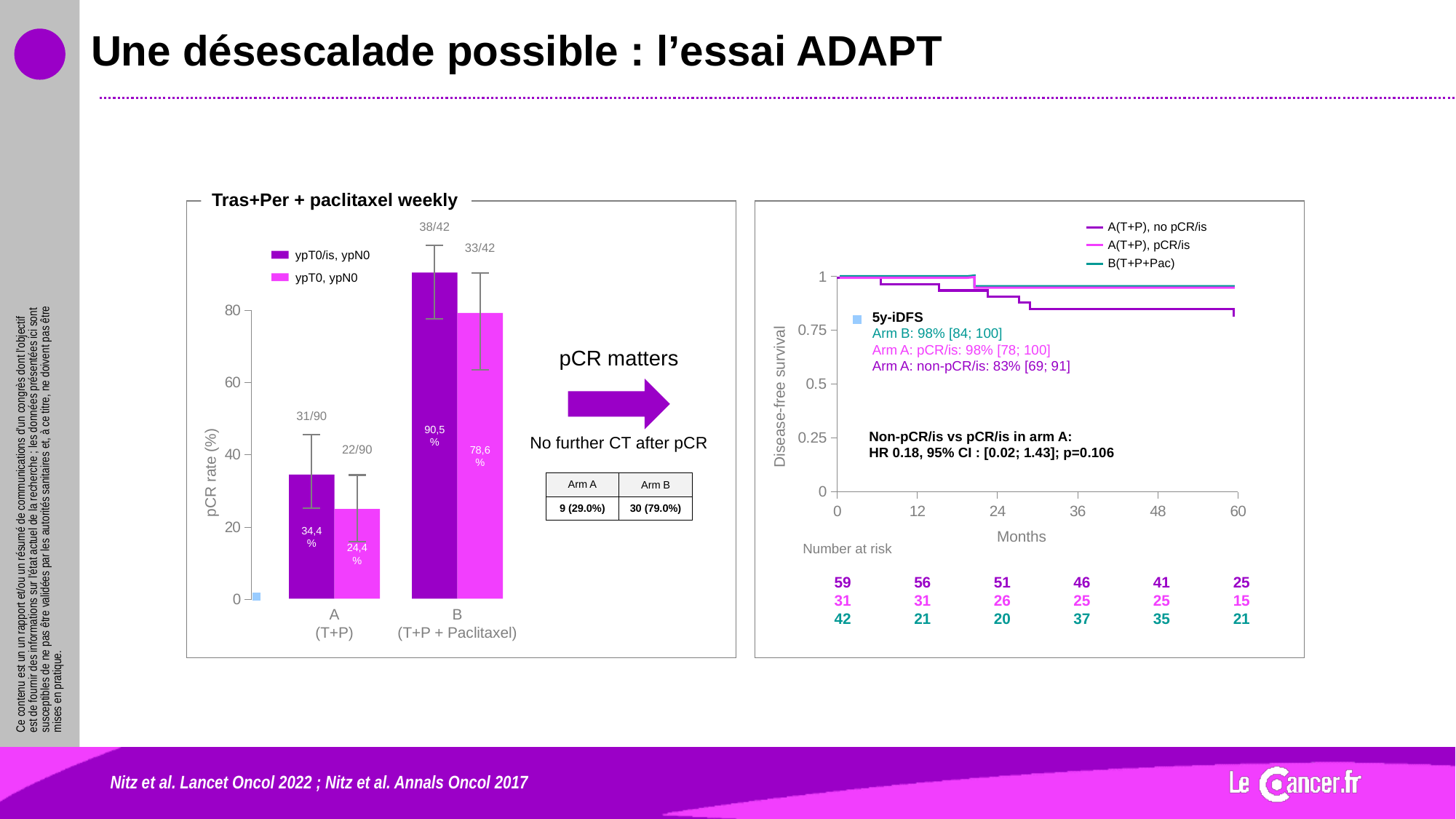
In the bar chart on the left, what is the pCR rate for ypT0, ypN0 in arm A (T+P)? 24,4% What kind of chart is the chart on the left of the slide? Bar chart In the disease-free survival chart on the right, how many series does the legend list? 3 In the bar chart on the left, what is the pCR rate for ypT0/is, ypN0 in arm B (T+P + Paclitaxel)? 90,5% In the bar chart on the left, what is the title printed above the chart? Tras+Per + paclitaxel weekly In the bar chart on the left, how many series does the legend list? 2 In the bar chart on the left, is the ypT0, ypN0 pCR rate for arm B greater or less than 60? greater In the bar chart on the left, what fraction is printed above the ypT0/is, ypN0 bar for arm A (T+P)? 31/90 In the disease-free survival chart on the right, what is the 5y-iDFS for Arm B? 98% [84; 100] In the bar chart on the left, what is the difference between the ypT0/is, ypN0 pCR rates of arm B and arm A? 56,1 percentage points In the bar chart on the left, which arm has the higher ypT0/is, ypN0 pCR rate? B (T+P + Paclitaxel) In the disease-free survival chart on the right, what is the number at risk for the A(T+P), no pCR/is group at 60 months? 25